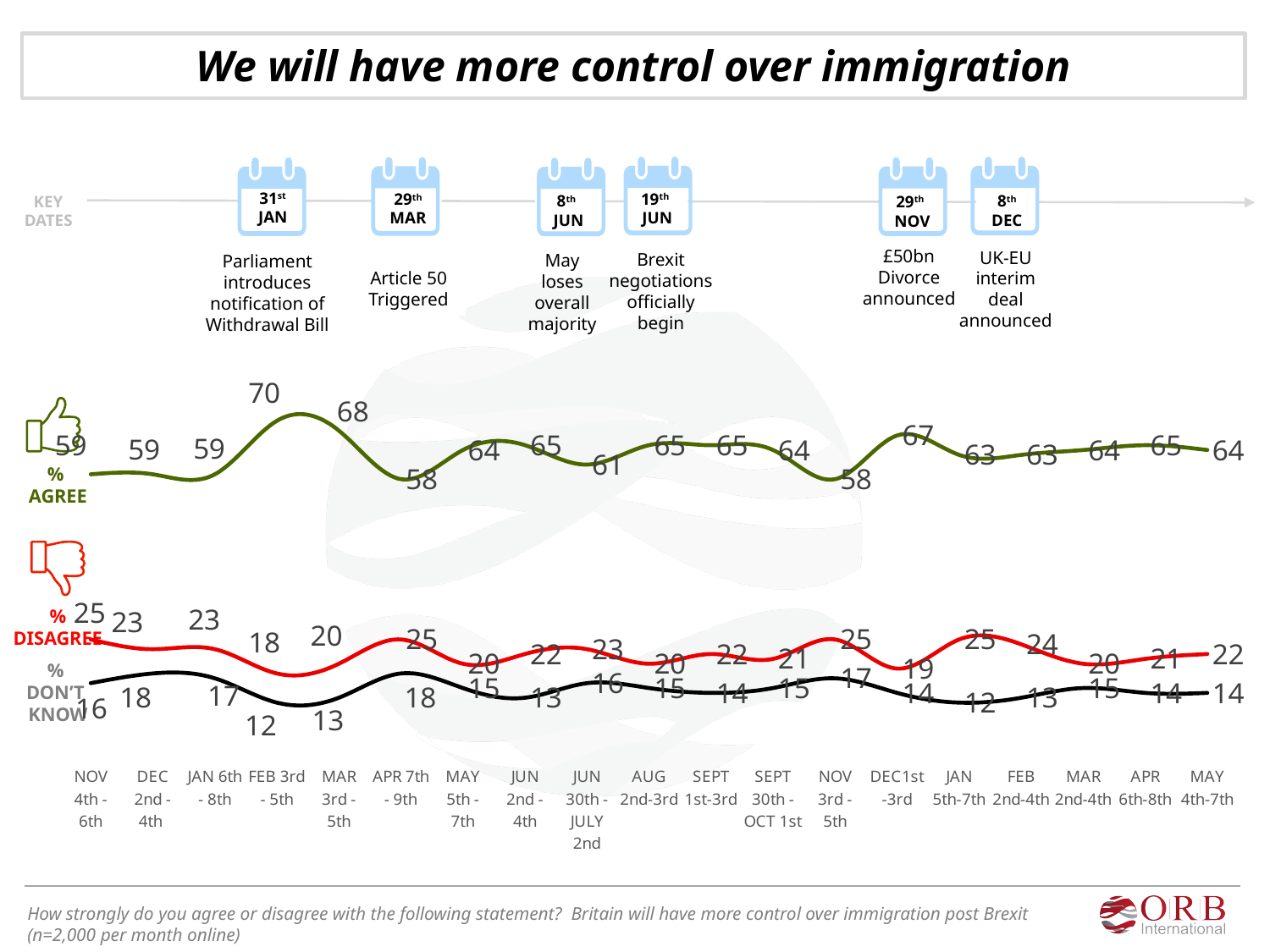
At which survey date is the % AGREE value highest? FEB 3rd - 5th What kind of chart is shown on the slide? Line chart What is the difference between the % AGREE value for FEB 3rd - 5th and the % AGREE value for APR 7th - 9th? 12 What is the % AGREE value for FEB 3rd - 5th? 70 What is the lowest % AGREE value shown on the chart? 58 What is the % AGREE value for MAY 4th - 7th? 64 Which has the larger % DISAGREE value: NOV 4th - 6th or FEB 3rd - 5th? NOV 4th - 6th What is the % DISAGREE value for DEC 1st - 3rd? 19 How many series are plotted on the chart? 3 How many survey dates are plotted along the x axis? 19 What colour is the % AGREE line? Green What is the % DON'T KNOW value for JAN 5th - 7th? 12